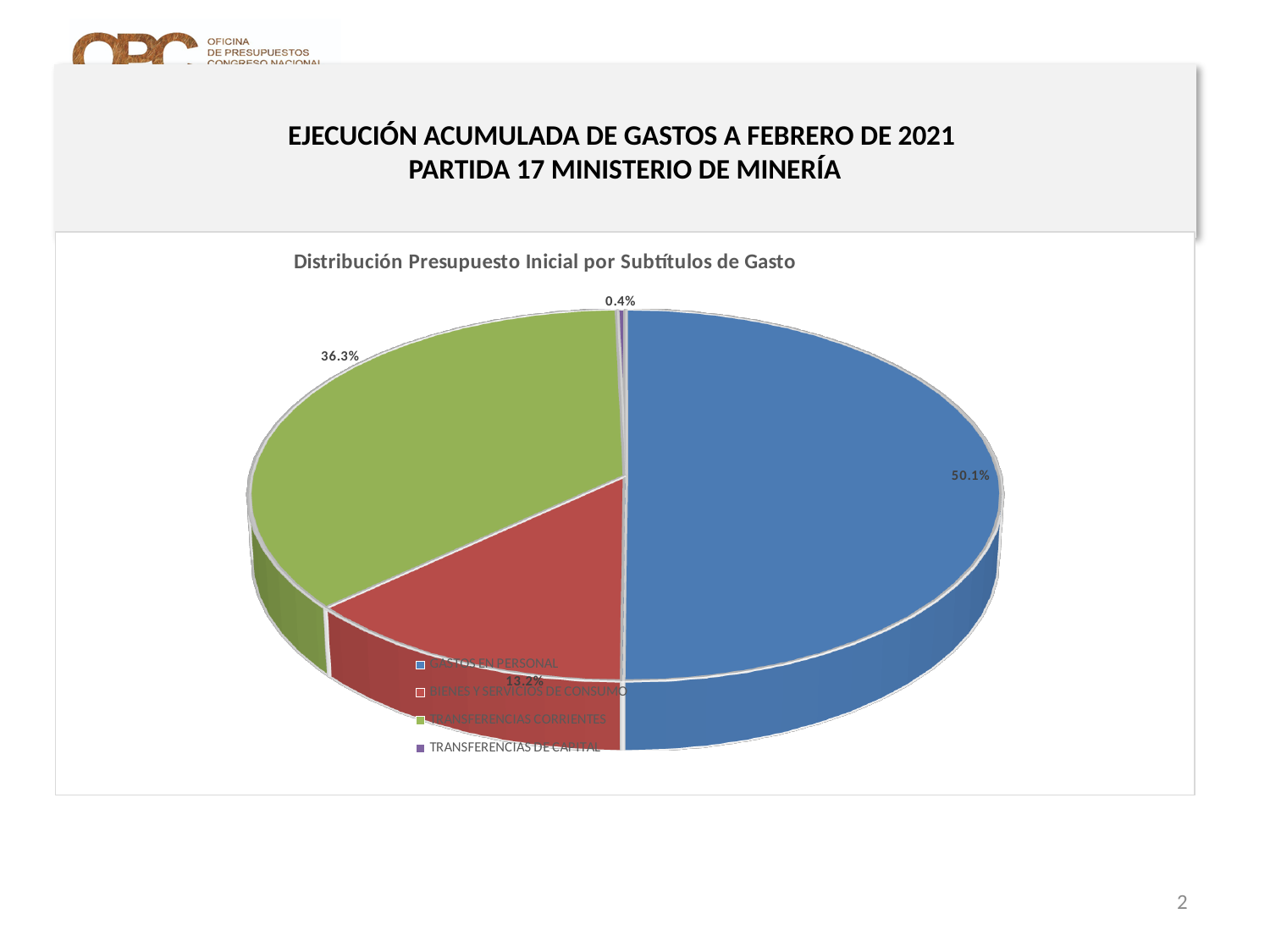
What share of the pie does GASTOS EN PERSONAL represent? 50.1% What share of the pie does TRANSFERENCIAS DE CAPITAL represent? 0.4% What colour is the slice for TRANSFERENCIAS CORRIENTES? Green What is the difference in percentage points between GASTOS EN PERSONAL and TRANSFERENCIAS CORRIENTES? 13.8 What share of the pie does BIENES Y SERVICIOS DE CONSUMO represent? 13.2% Which category has the smallest slice of the pie? TRANSFERENCIAS DE CAPITAL Which category has the largest slice of the pie? GASTOS EN PERSONAL Which is larger, the share for BIENES Y SERVICIOS DE CONSUMO or the share for TRANSFERENCIAS CORRIENTES? TRANSFERENCIAS CORRIENTES What is the title of the chart? Distribución Presupuesto Inicial por Subtítulos de Gasto How many categories does the pie chart show? 4 What kind of chart is shown on the slide? Pie chart